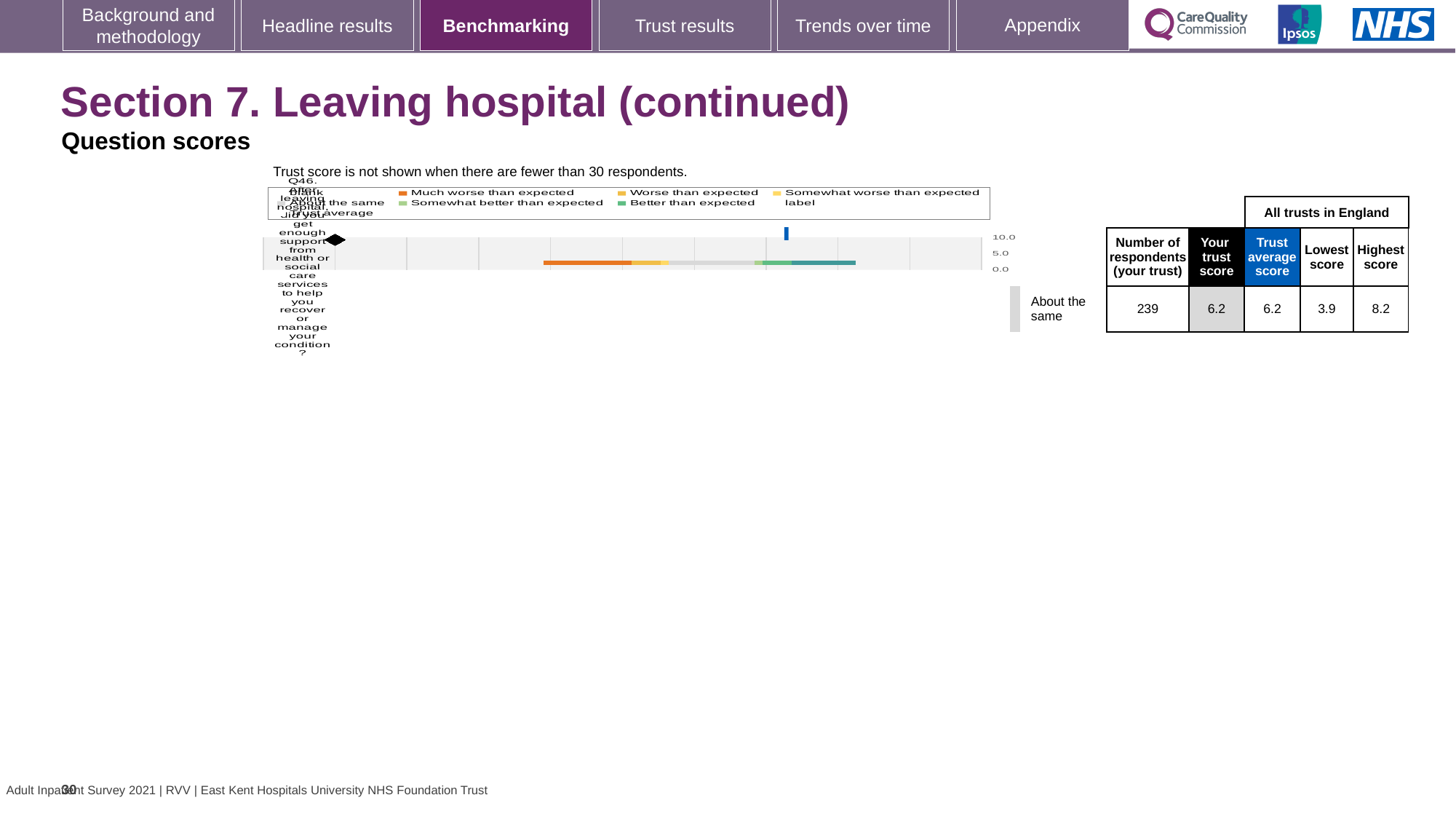
Which is larger for Q46: the trust's score or the lowest score in England? the trust's score What is the lowest score among all trusts in England for Q46? 3.9 What is the highest score among all trusts in England for Q46? 8.2 What is the trust average score for Q46 across all trusts in England? 6.2 How many questions (categories) are plotted in the chart? 1 Is the trust score for Q46 greater or less than 5.0 on the chart's axis? greater What kind of chart is shown on the slide? bar chart What is the difference between the highest score and the lowest score for Q46? 4.3 What benchmark category is the trust's Q46 score placed in, as labelled beside the chart? About the same What is the trust score for Q46 shown in the table next to the chart? 6.2 What is the difference between the highest score and the trust's score for Q46? 2.0 How many respondents from the trust answered Q46? 239